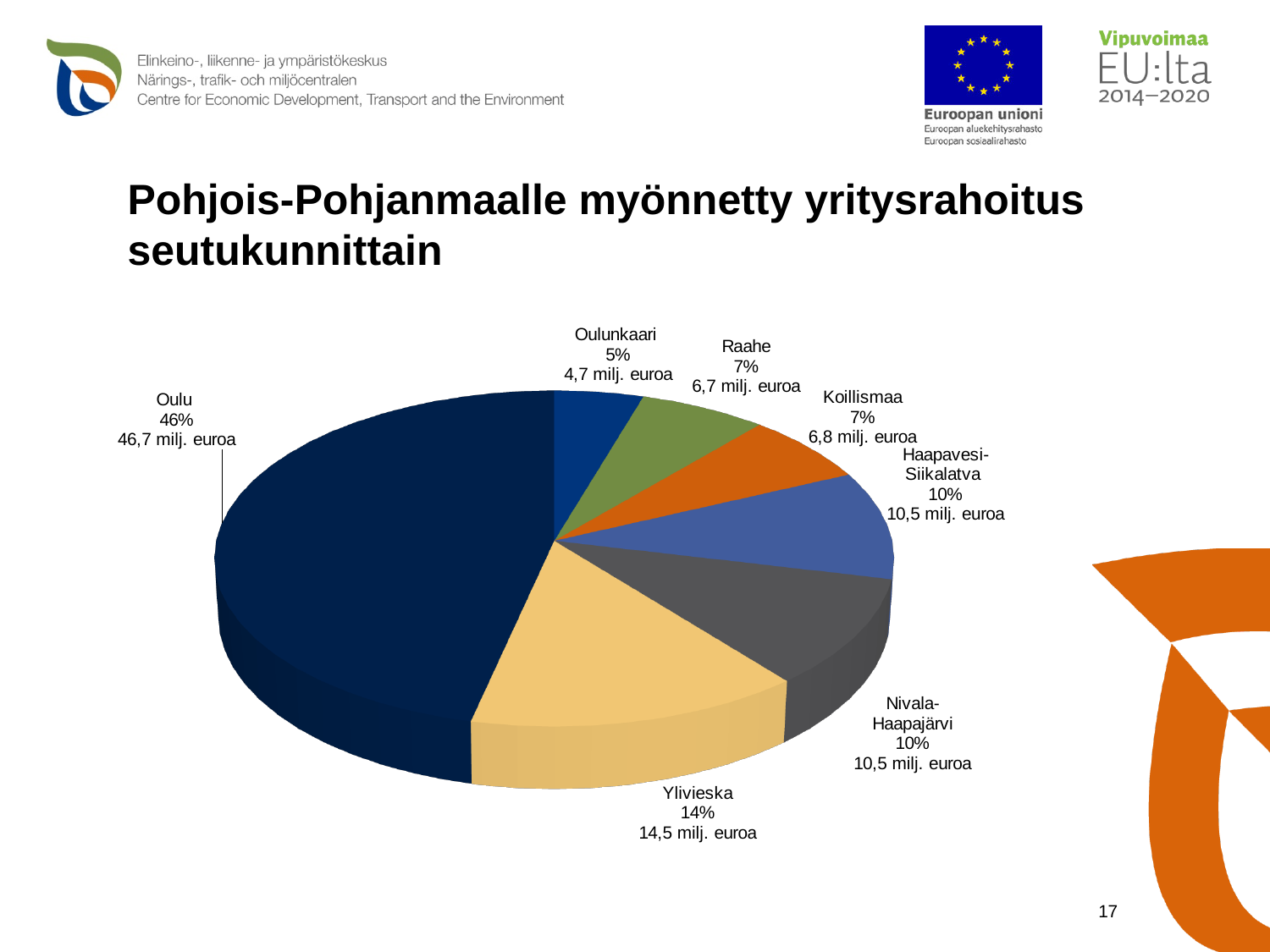
What share of the pie does Oulunkaari have? 5% What is the value in milj. euroa for Koillismaa? 6,8 milj. euroa Which region has the smallest slice of the pie? Oulunkaari What kind of chart is shown on the slide? pie chart What is the value in milj. euroa for Nivala-Haapajärvi? 10,5 milj. euroa What is the difference in milj. euroa between Oulu and Ylivieska? 32,2 milj. euroa Which region has the largest slice of the pie? Oulu What share of the pie does Oulu have? 46% Which is larger, the value for Raahe or the value for Koillismaa? Koillismaa What is the value in milj. euroa for Ylivieska? 14,5 milj. euroa What is the title of the chart on the slide? Pohjois-Pohjanmaalle myönnetty yritysrahoitus seutukunnittain How many slices does the pie chart have? 7